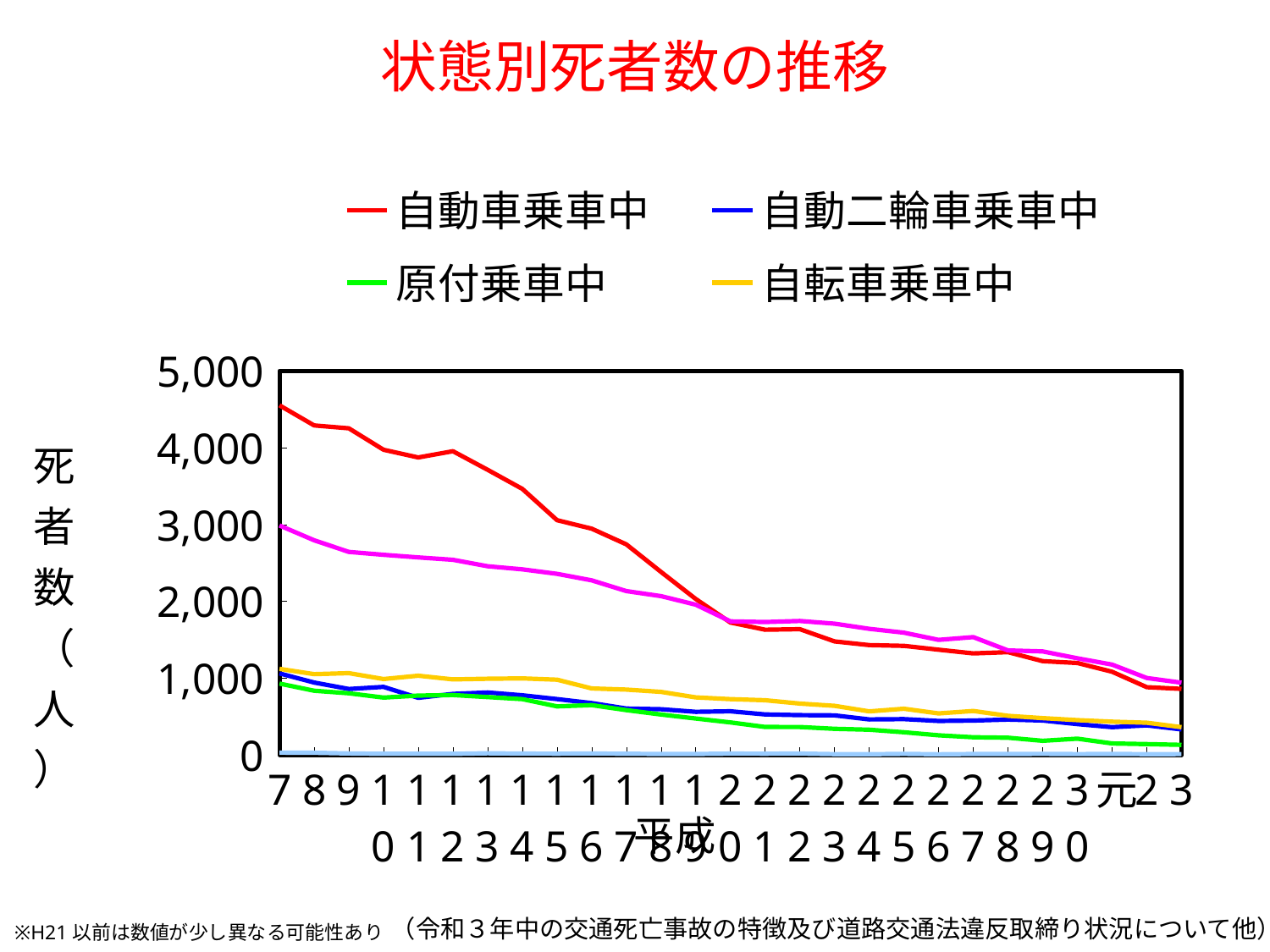
Is the value for 自動車乗車中 in 平成7 greater or less than 4,000? greater In 平成7, which is larger: the value for 自動車乗車中 or the value for 自動二輪車乗車中? 自動車乗車中 Is the value for 自動車乗車中 in 平成20 greater or less than 2,000? less Among the series listed in the legend, which has the lowest value in 令和3? 原付乗車中 Is the value for 自動二輪車乗車中 in 令和3 greater or less than 1,000? less What kind of chart is shown on the slide? line chart Among the series listed in the legend, which has the highest value in 平成7? 自動車乗車中 What is the title of the chart? 状態別死者数の推移 How many series does the legend list? 4 What is the label on the vertical axis? 死者数（人） Does the 自動車乗車中 line rise or fall overall from 平成7 to 令和3? fall